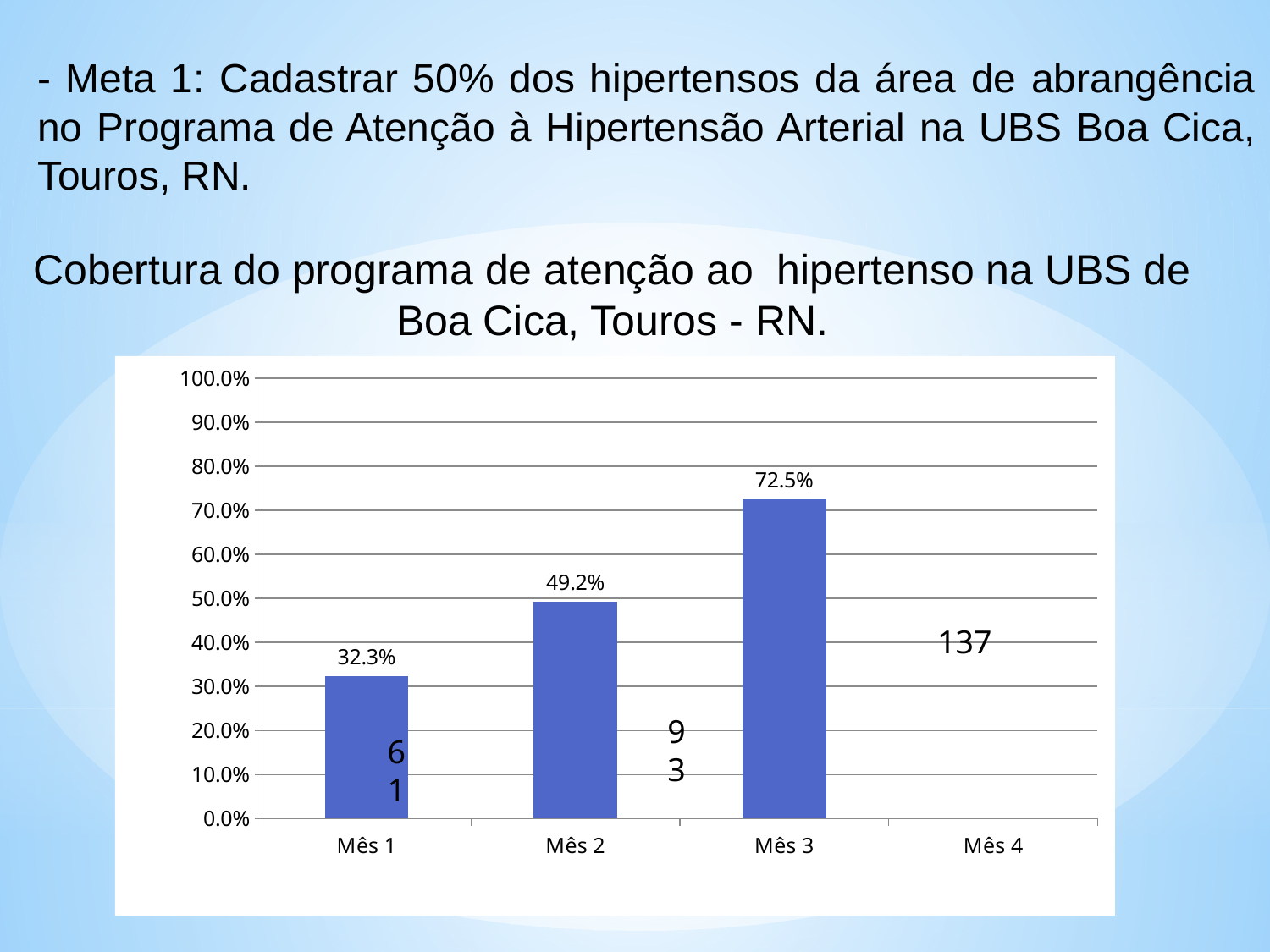
Which is larger, the value for Mês 2 or the value for Mês 3? Mês 3 Is the value for Mês 1 greater or less than 40.0%? less Which month has the highest value? Mês 3 Do the values rise or fall from Mês 1 to Mês 3? Rise What is the value for Mês 2? 49.2% What is the value for Mês 1? 32.3% Among the bars shown, which month has the lowest value? Mês 1 What is the difference between the values for Mês 3 and Mês 1? 40.2 percentage points What is the difference between the values for Mês 2 and Mês 1? 16.9 percentage points How many categories are shown on the x axis? 4 What is the value for Mês 3? 72.5% What kind of chart is shown on the slide? Bar chart